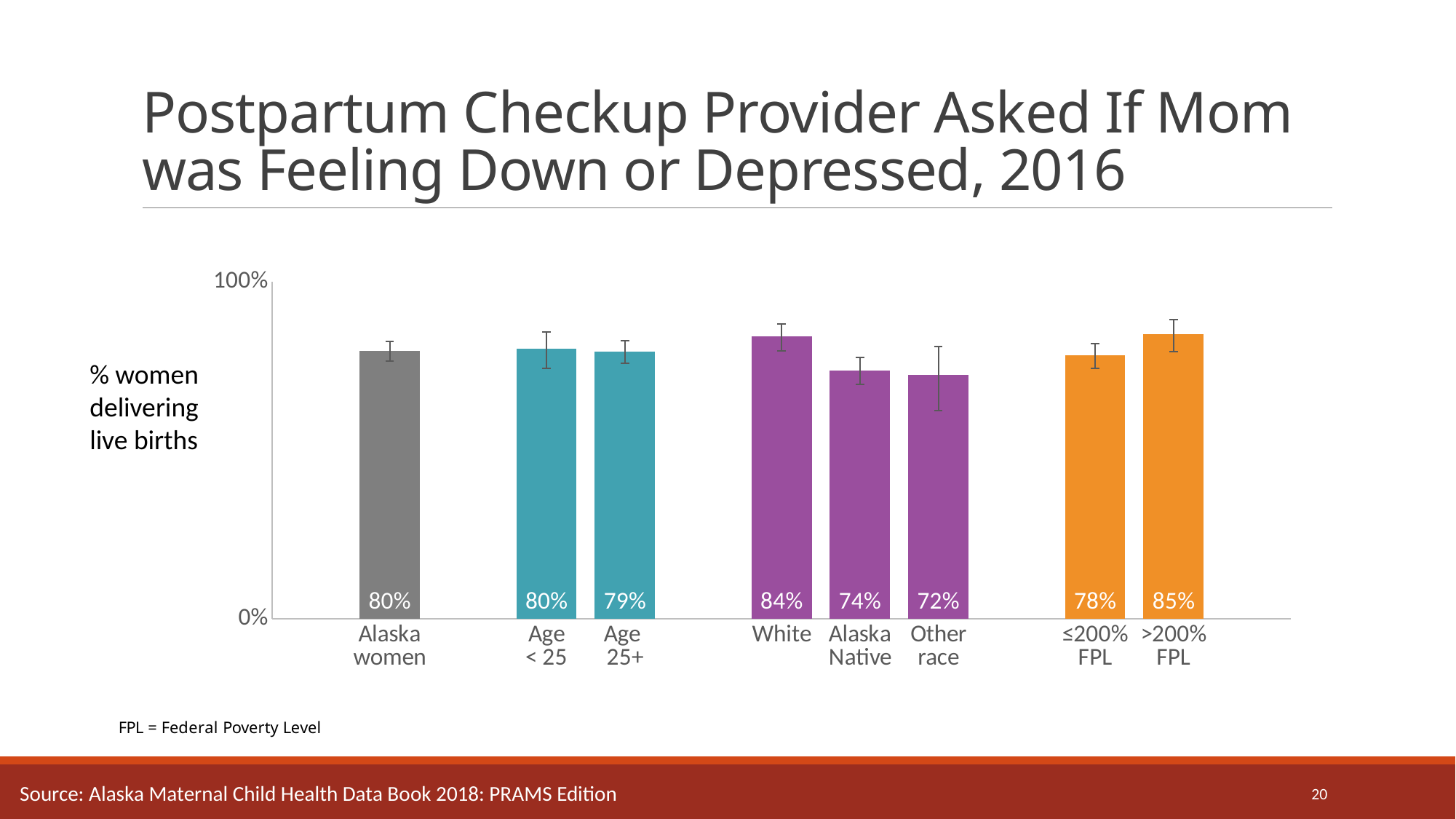
What kind of chart is shown on the slide? Bar chart Which category has the lowest value? Other race How many categories are shown in the chart? 8 Which is larger, the value for White or the value for Other race? White What is the difference between the values for >200% FPL and ≤200% FPL? 7% What is the difference between the values for White and Alaska Native? 10% What is the value for >200% FPL? 85% What is the value for Age 25+? 79% What is the value for Alaska women? 80% What does FPL stand for, according to the note on the slide? Federal Poverty Level Which category has the highest value? >200% FPL What is the value for Alaska Native? 74%